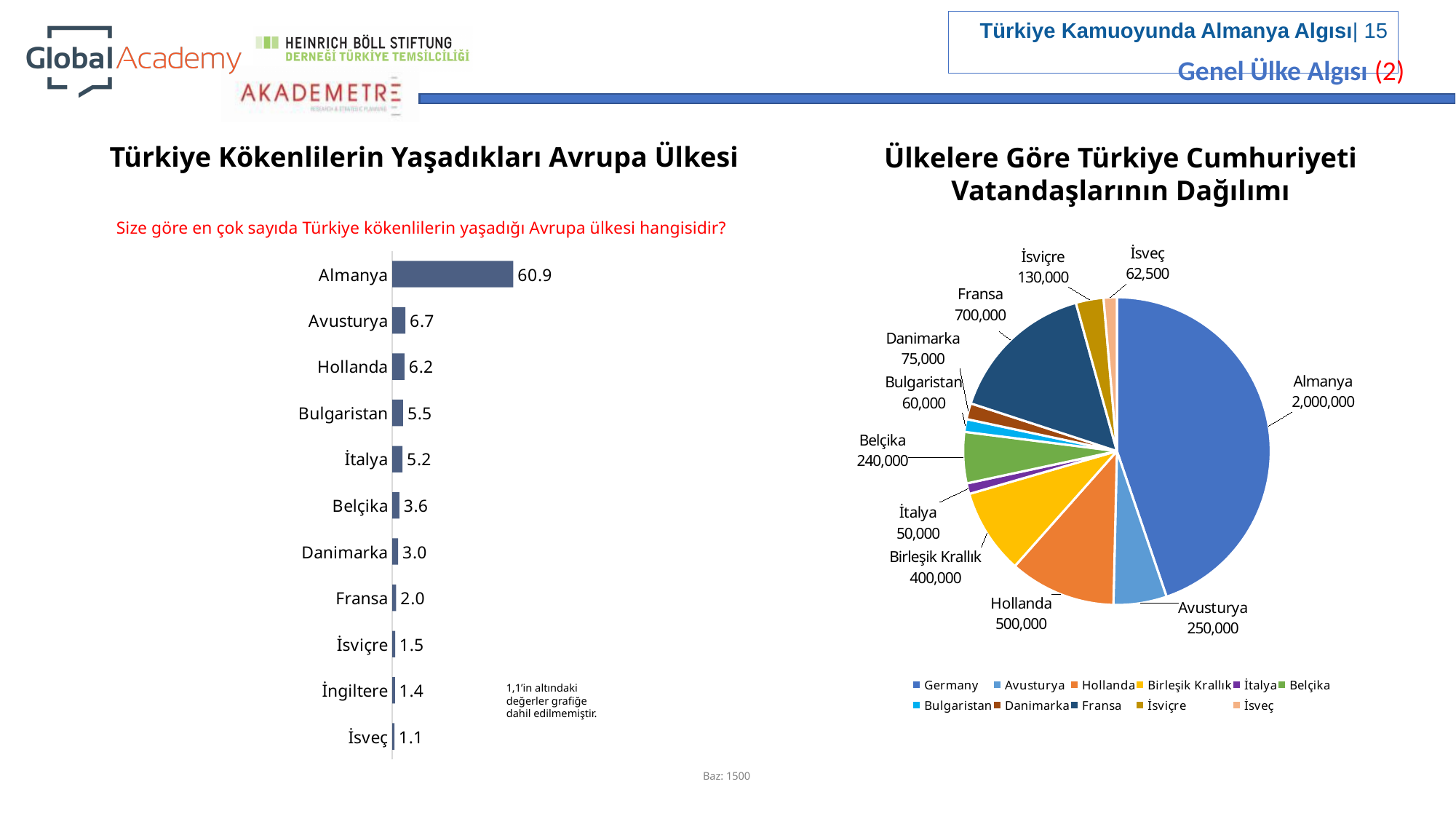
What type of chart is 'Türkiye Kökenlilerin Yaşadıkları Avrupa Ülkesi'? Bar chart In the bar chart 'Türkiye Kökenlilerin Yaşadıkları Avrupa Ülkesi', which is larger, the value for Belçika or the value for Danimarka? Belçika How many entries does the legend of the pie chart 'Ülkelere Göre Türkiye Cumhuriyeti Vatandaşlarının Dağılımı' list? 11 In the pie chart 'Ülkelere Göre Türkiye Cumhuriyeti Vatandaşlarının Dağılımı', what is the difference between the values for Hollanda and Birleşik Krallık? 100,000 How many countries are shown in the bar chart 'Türkiye Kökenlilerin Yaşadıkları Avrupa Ülkesi'? 11 In the bar chart 'Türkiye Kökenlilerin Yaşadıkları Avrupa Ülkesi', what is the value for Almanya? 60.9 In the pie chart 'Ülkelere Göre Türkiye Cumhuriyeti Vatandaşlarının Dağılımı', which country has the largest slice? Almanya In the pie chart 'Ülkelere Göre Türkiye Cumhuriyeti Vatandaşlarının Dağılımı', what is the value for Fransa? 700,000 In the bar chart 'Türkiye Kökenlilerin Yaşadıkları Avrupa Ülkesi', what is the value for Bulgaristan? 5.5 In the bar chart 'Türkiye Kökenlilerin Yaşadıkları Avrupa Ülkesi', which country has the lowest value? İsveç What type of chart is 'Ülkelere Göre Türkiye Cumhuriyeti Vatandaşlarının Dağılımı'? Pie chart In the bar chart 'Türkiye Kökenlilerin Yaşadıkları Avrupa Ülkesi', what is the difference between the values for Avusturya and Hollanda? 0.5